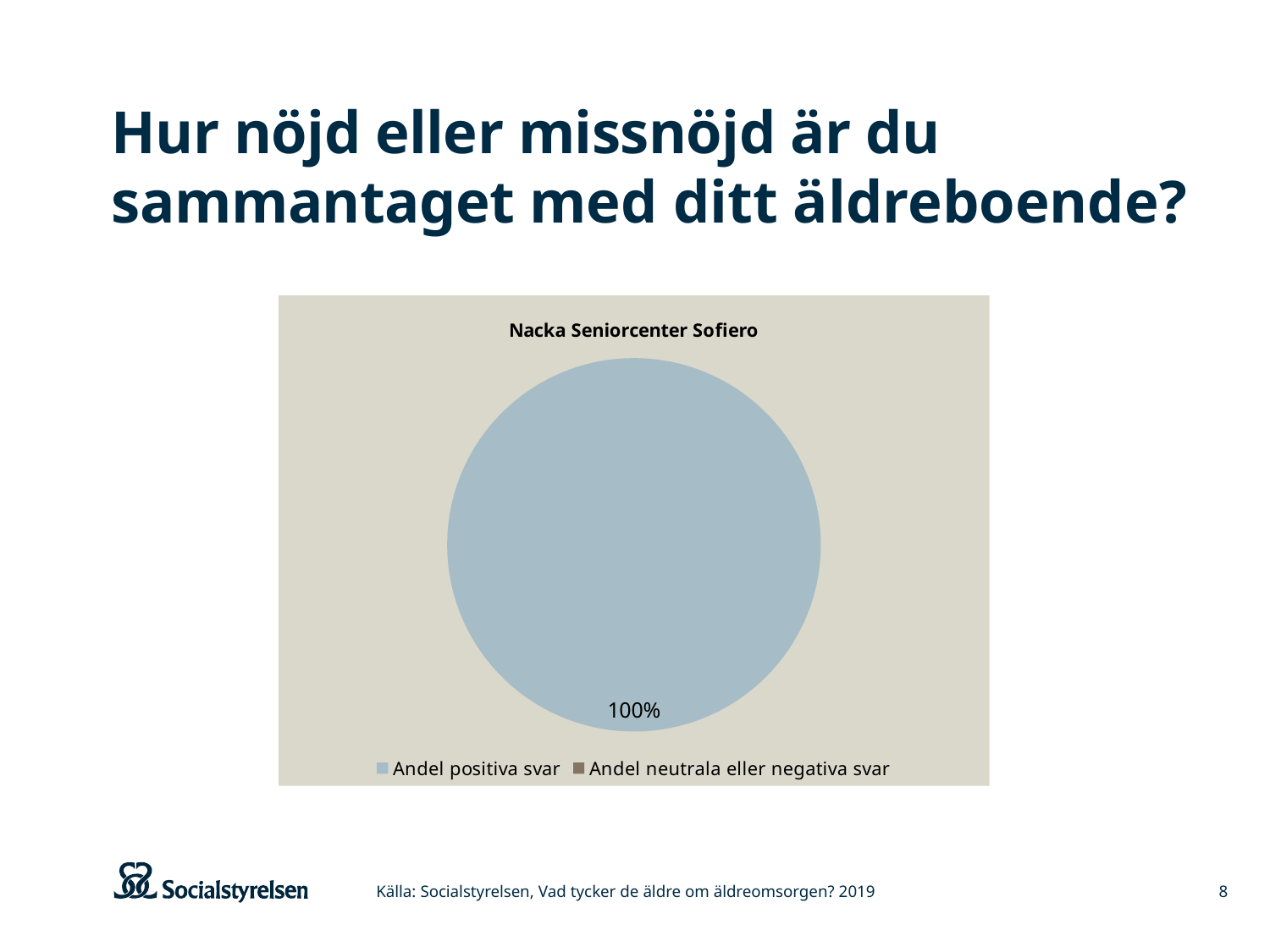
What is the second entry listed in the chart legend? Andel neutrala eller negativa svar Which is larger, the share for Andel positiva svar or the share for Andel neutrala eller negativa svar? Andel positiva svar Which legend category makes up the largest share of the pie? Andel positiva svar What is the title of the chart? Nacka Seniorcenter Sofiero How many entries does the chart legend list? 2 What share of the pie is labelled for Andel positiva svar? 100% What kind of chart is shown on the slide? pie chart What is the only percentage value printed on the pie chart? 100% Is the share for Andel positiva svar greater or less than 50%? greater